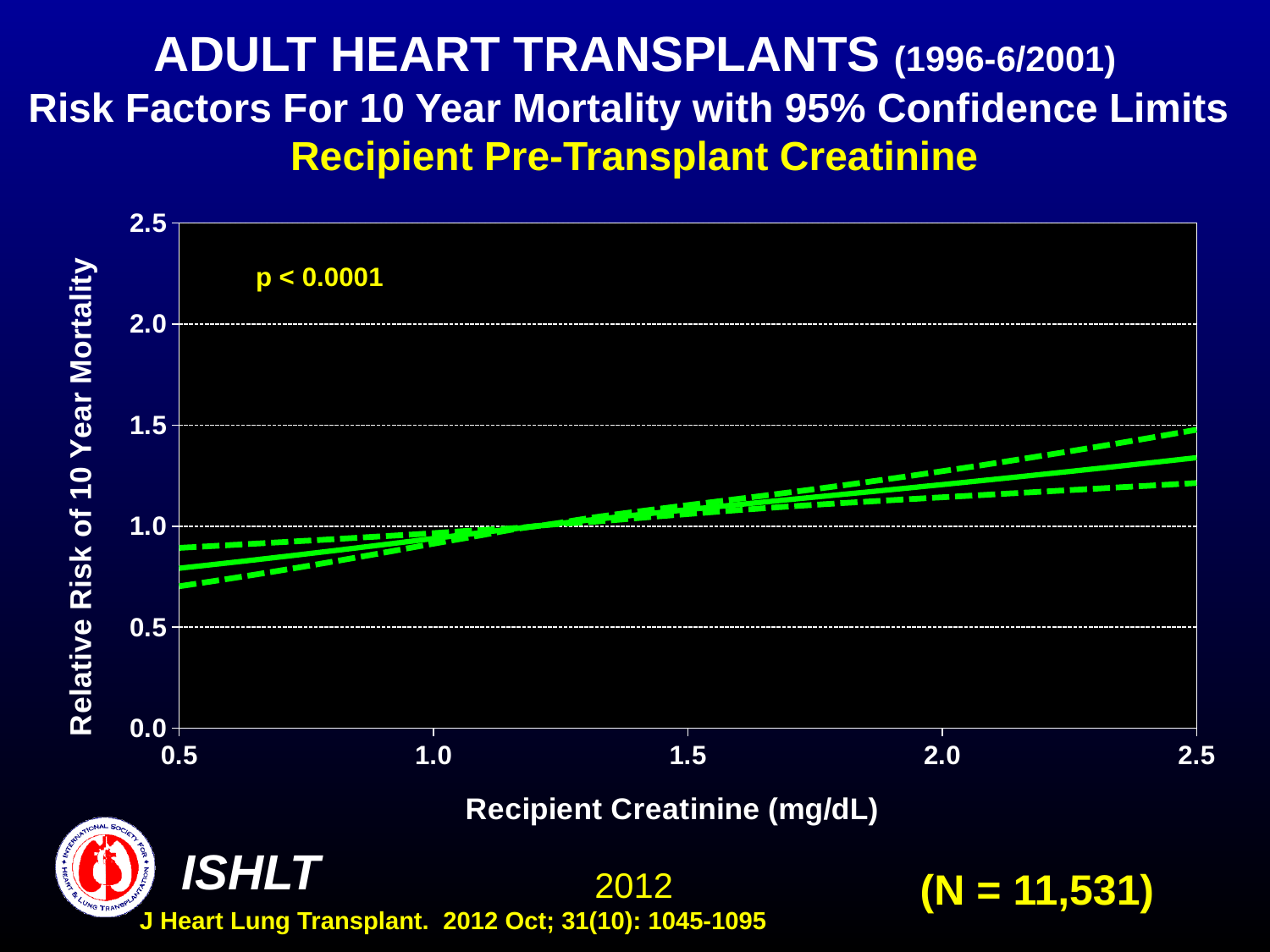
What kind of chart is shown on the slide? line chart Is the relative risk of 10 year mortality (solid line) at a recipient creatinine of 0.5 mg/dL greater or less than 1.0? less Which is larger: the relative risk of 10 year mortality at a recipient creatinine of 1.0 mg/dL or at 2.0 mg/dL? 2.0 mg/dL Does the relative risk of 10 year mortality rise or fall as recipient creatinine increases from 0.5 to 2.5 mg/dL? rise Is the relative risk of 10 year mortality (solid line) at a recipient creatinine of 2.5 mg/dL greater or less than 1.0? greater How many lines are plotted on the chart? 3 What is the label of the x axis? Recipient Creatinine (mg/dL) What p-value is shown on the chart? p < 0.0001 Is the relative risk of 10 year mortality (solid line) at a recipient creatinine of 2.5 mg/dL greater or less than 1.5? less